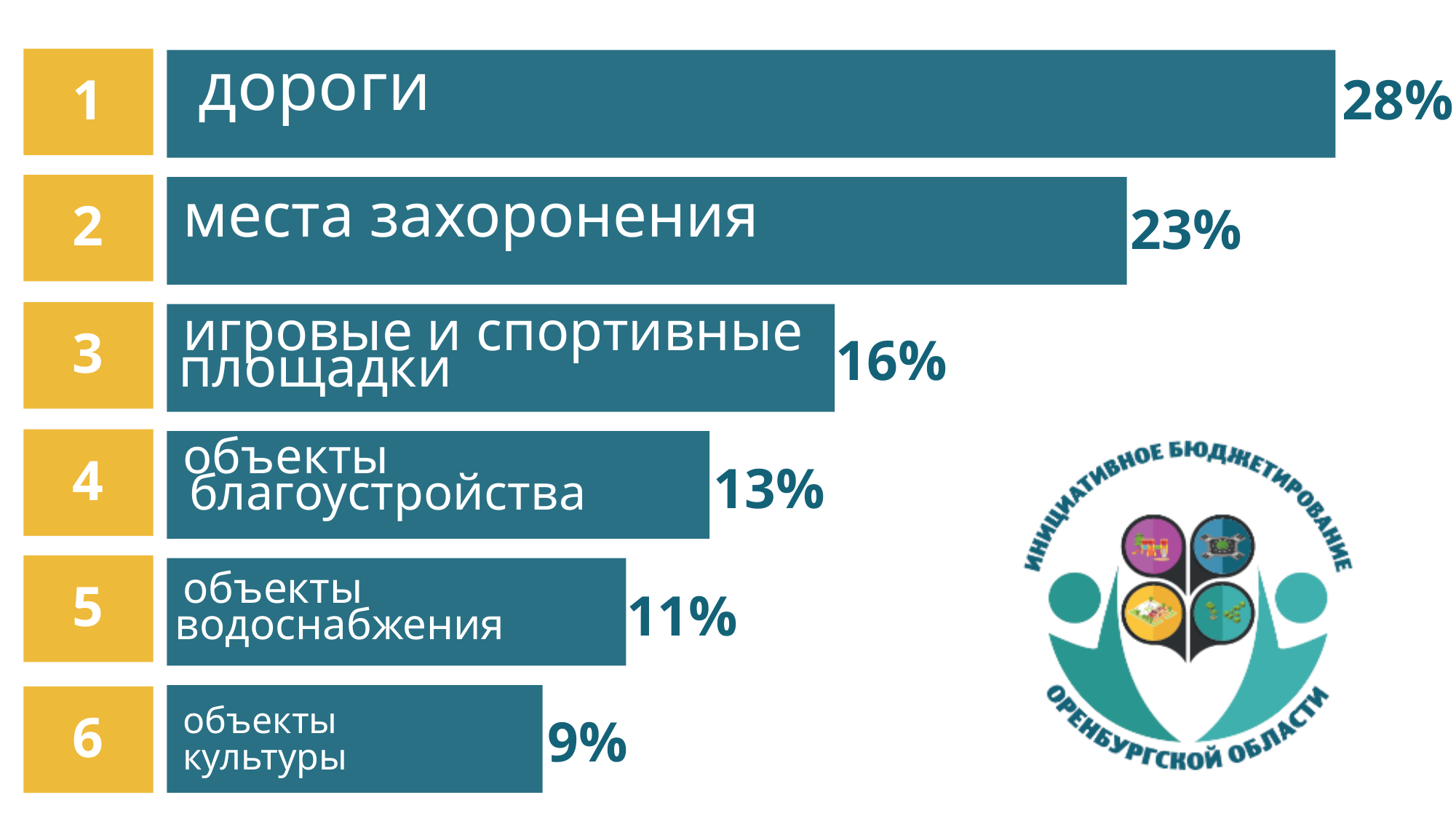
What kind of chart is shown on the slide? bar chart What is the difference between the values for дороги and места захоронения? 5% Which category has the lowest value? объекты культуры What is the difference between the values for объекты благоустройства and объекты культуры? 4% What is the value for объекты водоснабжения? 11% Which is larger, the value for игровые и спортивные площадки or the value for объекты водоснабжения? игровые и спортивные площадки Which category has the highest value? дороги What is the value for игровые и спортивные площадки? 16% What is the value for места захоронения? 23% What number is shown next to the category объекты благоустройства? 4 What is the value for дороги? 28% How many categories are shown in the chart? 6